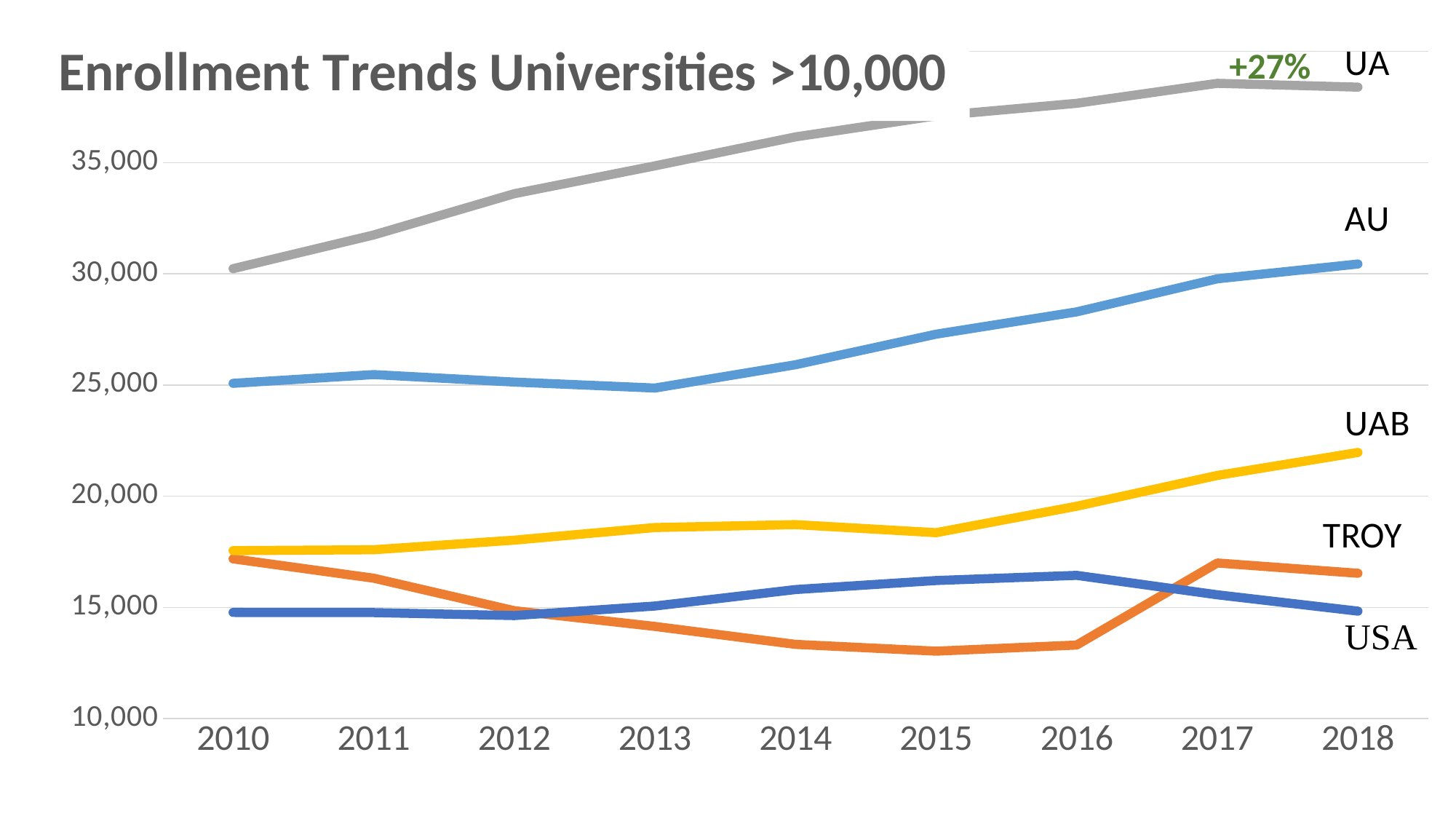
How many years are shown along the x axis? 9 How many universities (series) are plotted on the chart? 5 Is the enrollment for UAB in 2018 greater or less than 20,000? greater Which university has the lowest enrollment in 2018? USA Does the enrollment for UA rise or fall from 2010 to 2017? rise Which university has the lowest enrollment in 2015? TROY Is the enrollment for UA in 2012 greater or less than 30,000? greater What kind of chart is shown on the slide? line chart Is the enrollment for TROY in 2015 greater or less than 15,000? less Which university has the highest enrollment in 2018? UA In 2018, which has the larger enrollment, TROY or USA? TROY What percentage change is annotated next to the UA line? +27%